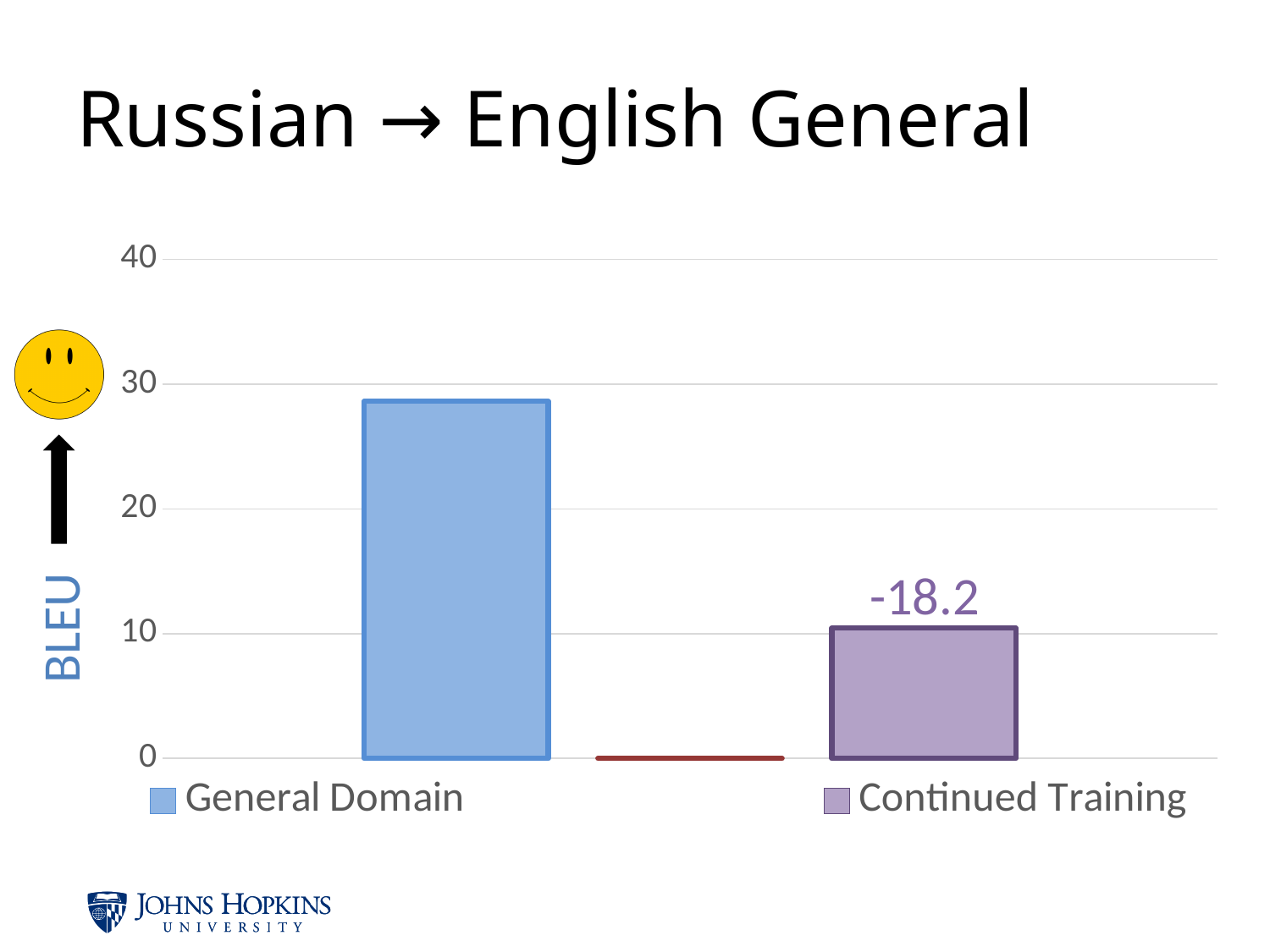
What number is printed above the Continued Training bar? -18.2 What kind of chart is shown on the slide? bar chart How many series does the legend list? 2 Is the value for Continued Training greater or less than 5? greater Is the value for General Domain greater or less than 30? less What is the label on the vertical axis? BLEU Is the value for General Domain greater or less than 20? greater What is the highest tick value shown on the vertical axis? 40 Which legend series has the tallest bar? General Domain Which series has the higher BLEU score, General Domain or Continued Training? General Domain